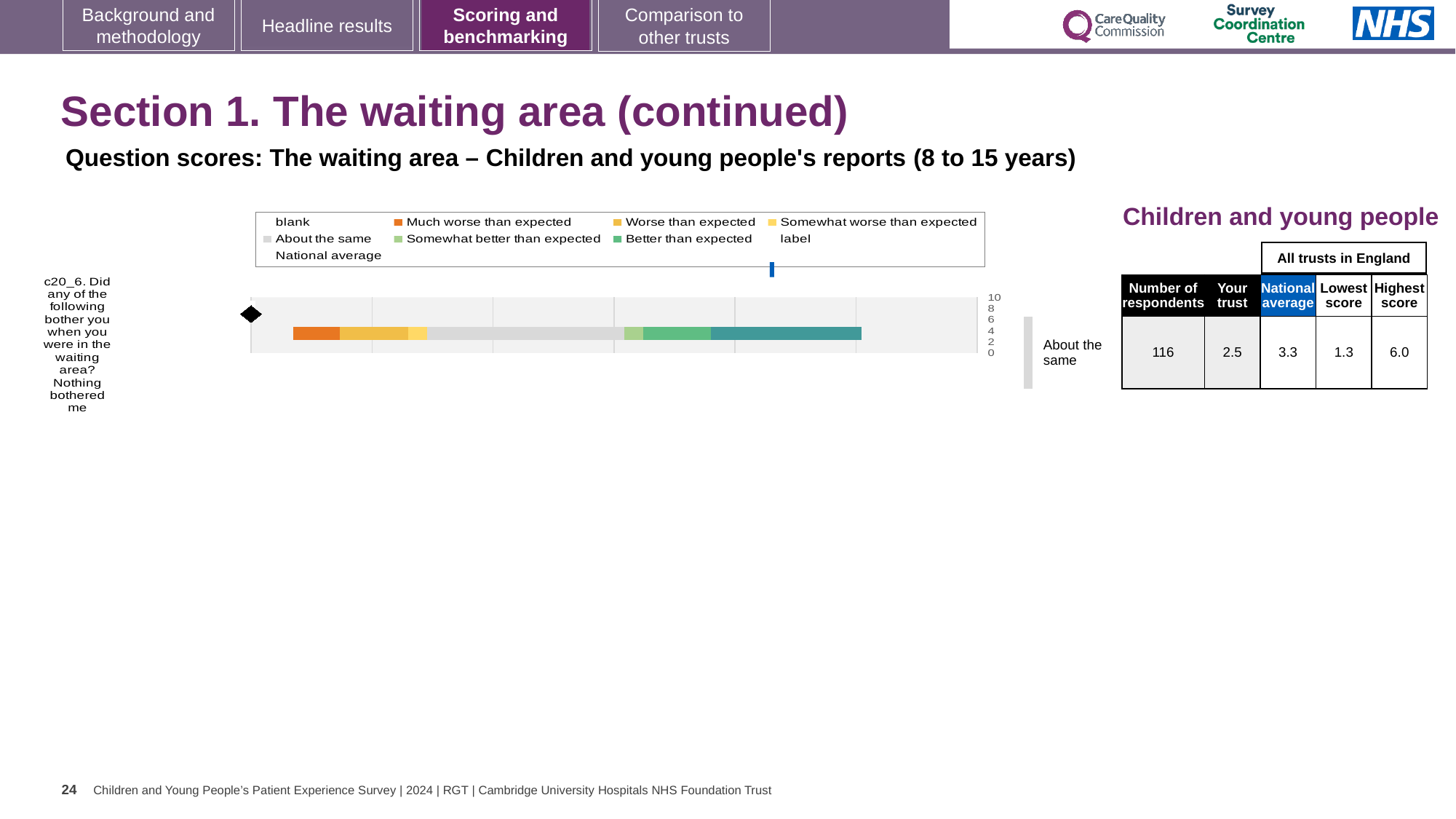
What is the highest score among all trusts in England for question c20_6? 6.0 By how much does the national average exceed the 'Your trust' score for question c20_6? 0.8 What is the lowest score among all trusts in England for question c20_6? 1.3 What is the maximum value shown on the chart's score axis? 10 Which is larger for question c20_6: the 'Your trust' score or the national average? National average What is the 'Your trust' score for question c20_6 (Nothing bothered me in the waiting area)? 2.5 How many respondents answered question c20_6? 116 How many survey questions are plotted in the chart? 1 What kind of chart is shown on the slide? bar chart What is the national average score for question c20_6? 3.3 What is the difference between the highest score and the lowest score for question c20_6? 4.7 What benchmark category label is shown to the right of the bar for question c20_6? About the same